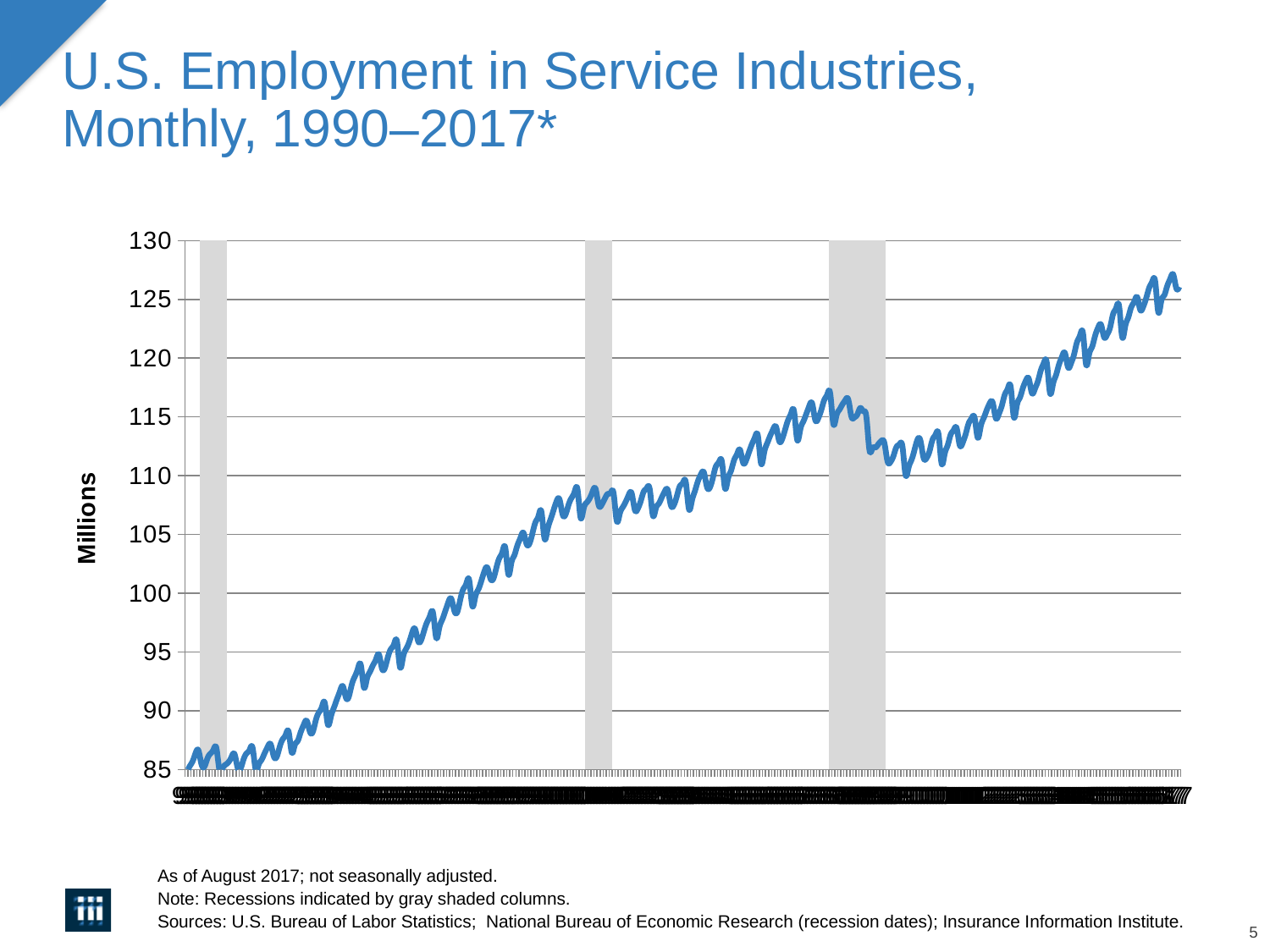
Is the value at the start of the series (1990) greater or less than 90? less Is the value at the end of the series (2017) greater or less than 130? less Overall, do the values rise or fall from the start of the series in 1990 to the end in 2017? rise What do the gray shaded columns on the chart indicate? Recessions What is the label on the vertical axis? Millions Is the value at the end of the series (2017) greater or less than 120? greater What kind of chart is shown on the slide? line chart Does the line rise or fall during the third gray shaded column? fall How many gray shaded columns appear on the chart? 3